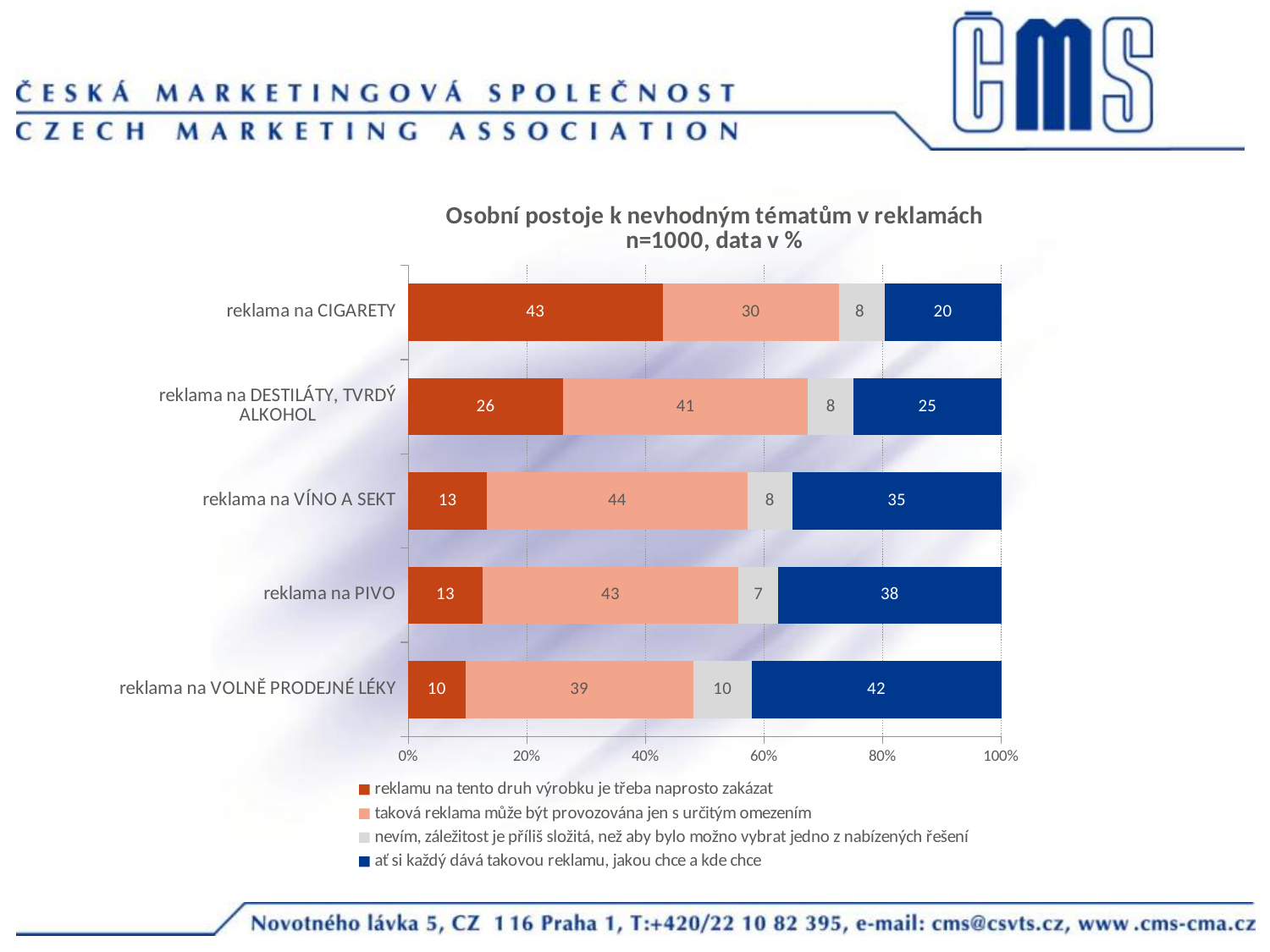
How many series does the legend list? 4 Which is larger: the 'nevím' value for 'reklama na VOLNĚ PRODEJNÉ LÉKY' or for 'reklama na PIVO'? reklama na VOLNĚ PRODEJNÉ LÉKY What is the total of the stacked bar for 'reklama na DESTILÁTY, TVRDÝ ALKOHOL'? 100 How many categories (types of advertising) are shown in the chart? 5 Which category has the lowest value for 'ať si každý dává takovou reklamu, jakou chce a kde chce'? reklama na CIGARETY Which category has the highest value for 'reklamu na tento druh výrobku je třeba naprosto zakázat'? reklama na CIGARETY What is the value for 'ať si každý dává takovou reklamu, jakou chce a kde chce' for 'reklama na VOLNĚ PRODEJNÉ LÉKY'? 42 What is the value for 'taková reklama může být provozována jen s určitým omezením' for 'reklama na VÍNO A SEKT'? 44 What is the value for 'reklamu na tento druh výrobku je třeba naprosto zakázat' for 'reklama na CIGARETY'? 43 What is the difference between the 'ať si každý dává takovou reklamu, jakou chce a kde chce' values for 'reklama na PIVO' and 'reklama na CIGARETY'? 18 What type of chart is shown on the slide? stacked bar chart What is the title of the chart? Osobní postoje k nevhodným tématům v reklamách n=1000, data v %